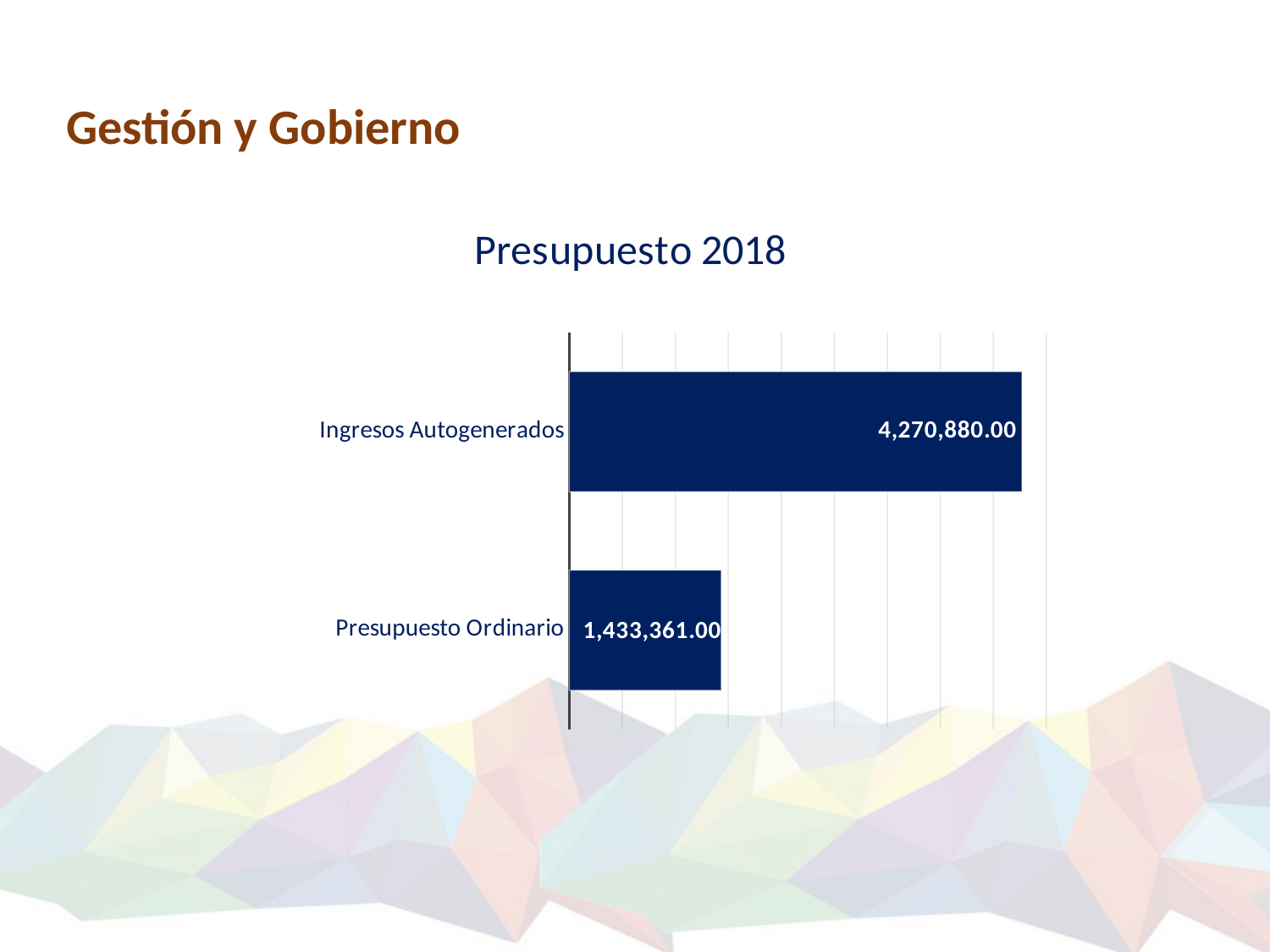
Which category has the lowest value in the Presupuesto 2018 chart? Presupuesto Ordinario What kind of chart is shown on the slide? Bar chart What is the value for Presupuesto Ordinario in the Presupuesto 2018 chart? 1,433,361.00 How many categories are shown in the Presupuesto 2018 chart? 2 Which category has the highest value in the Presupuesto 2018 chart? Ingresos Autogenerados Which is larger, Ingresos Autogenerados or Presupuesto Ordinario? Ingresos Autogenerados What is the title of the chart on the slide? Presupuesto 2018 What colour are the bars in the Presupuesto 2018 chart? Dark blue What is the value for Ingresos Autogenerados in the Presupuesto 2018 chart? 4,270,880.00 What is the difference between the values for Ingresos Autogenerados and Presupuesto Ordinario? 2,837,519.00